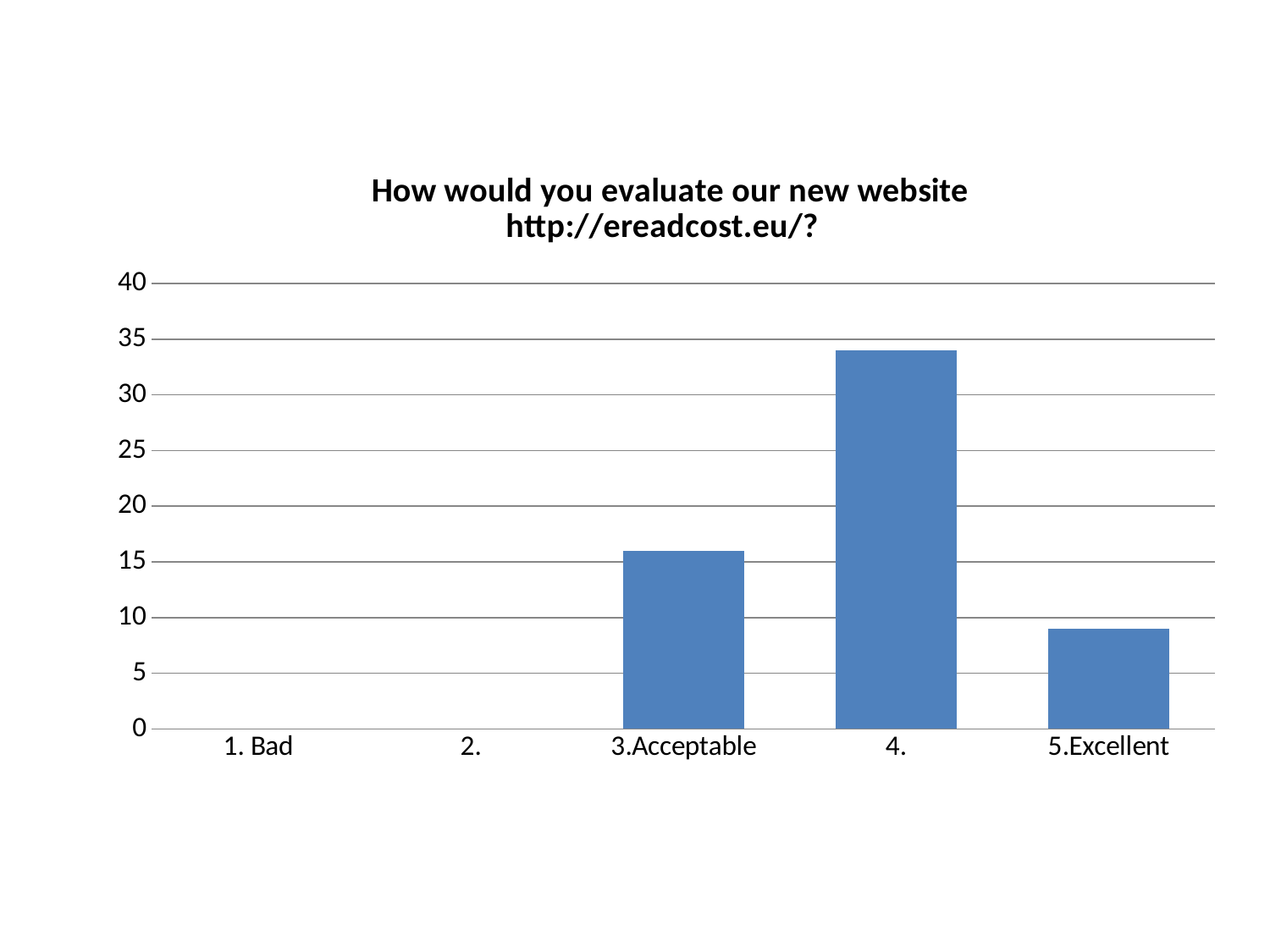
Is the value for 5.Excellent greater or less than 10? less Which category has the highest value? 4. What is the highest value shown on the y axis? 40 Which is larger, the value for 3.Acceptable or the value for 5.Excellent? 3.Acceptable Is the value for 3.Acceptable greater or less than 20? less What kind of chart is shown on the slide? bar chart Is the value for 4. greater or less than 30? greater How many categories have no visible bar? 2 How many categories are shown on the x axis? 5 What is the title of the chart? How would you evaluate our new website http://ereadcost.eu/?